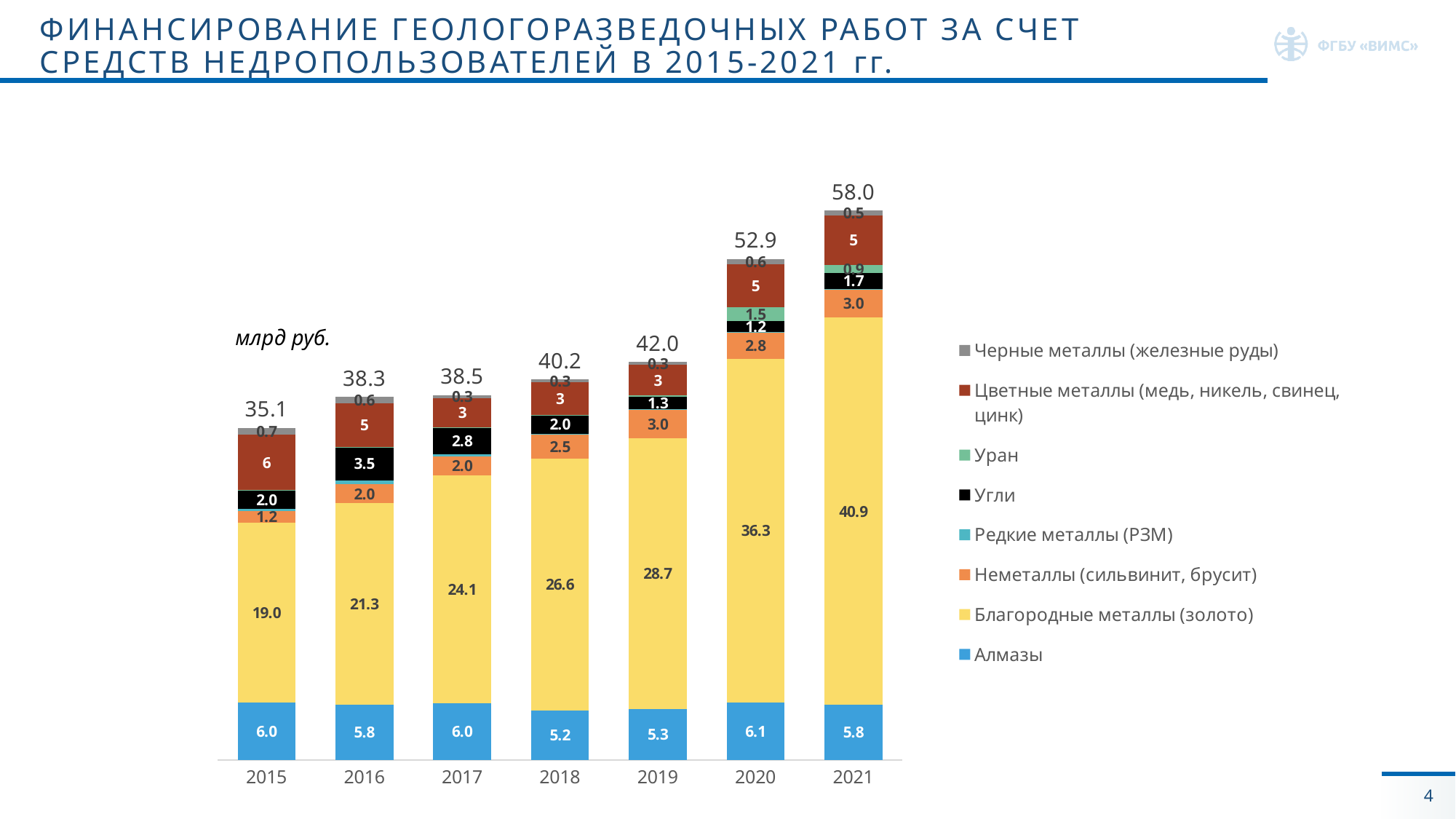
How many years are shown on the x axis? 7 Which is larger: the value for Благородные металлы (золото) in 2017 or in 2018? 2018 What is the total value shown above the bar for 2021? 58.0 What is the value for Алмазы in 2018? 5.2 Which year has the lowest total bar? 2015 What is the difference between the total for 2021 and the total for 2020? 5.1 What kind of chart is shown on the slide? Stacked bar chart Which year has the highest total bar? 2021 What is the value for Неметаллы (сильвинит, брусит) in 2020? 2.8 What is the value for Угли in 2016? 3.5 What is the value for Благородные металлы (золото) in 2019? 28.7 How many series does the legend list? 8